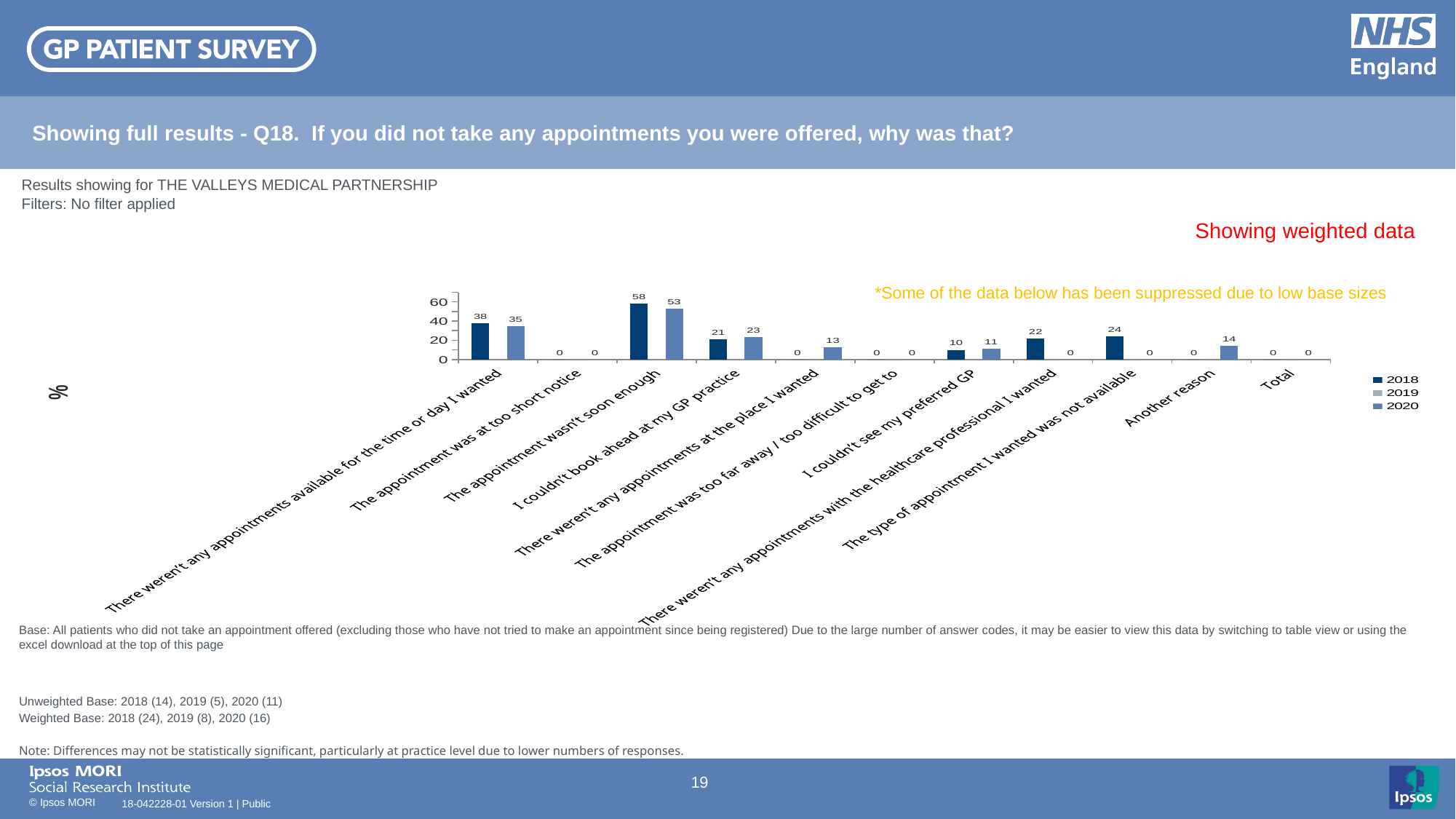
What is the difference between the 2018 and 2020 values for "There weren't any appointments available for the time or day I wanted"? 3 How many categories are shown on the x axis of the chart? 11 Which category has the highest 2018 value? The appointment wasn't soon enough What kind of chart is shown on the slide? Bar chart What is the 2020 value for "There weren't any appointments at the place I wanted"? 13 What is the difference between the 2018 and 2020 values for "The appointment wasn't soon enough"? 5 What is the 2018 value for "The type of appointment I wanted was not available"? 24 What is the 2018 value for "The appointment wasn't soon enough"? 58 What is the 2020 value for "The appointment wasn't soon enough"? 53 What is the 2020 value for "Another reason"? 14 How many series does the legend list? 3 For "I couldn't book ahead at my GP practice", which year has the larger value, 2018 or 2020? 2020